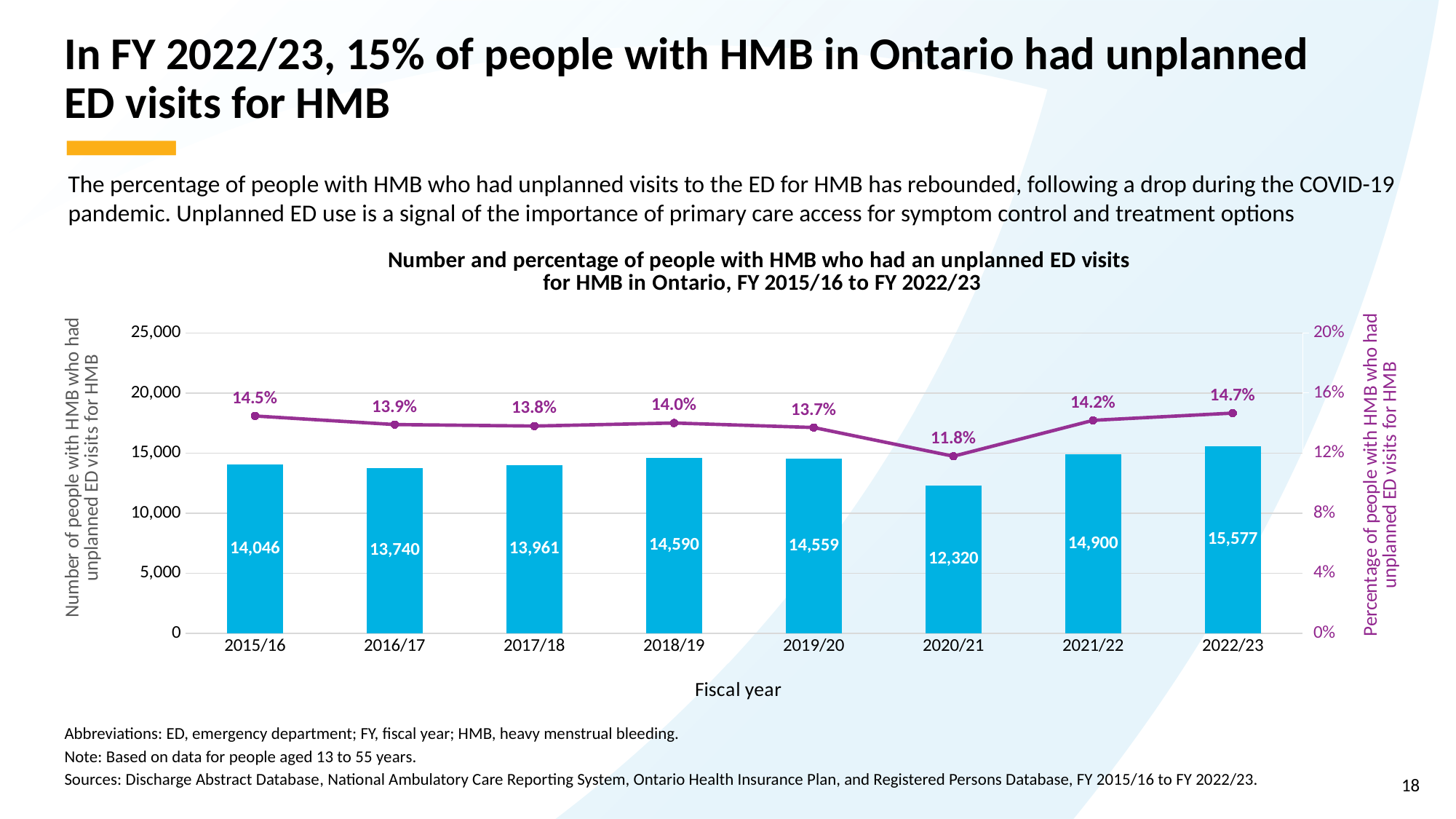
Is the number of people with unplanned ED visits in FY 2020/21 greater or less than 15,000? less Which fiscal year has the highest percentage of people with HMB who had unplanned ED visits? 2022/23 Which fiscal year has the lowest number of people with HMB who had unplanned ED visits? 2020/21 What kind of chart is used to show the number of people with HMB who had unplanned ED visits? bar chart How many fiscal years are shown on the x axis of the chart? 8 What is the number of people with HMB who had unplanned ED visits for HMB in FY 2022/23? 15,577 Did the percentage of people with HMB who had unplanned ED visits rise or fall from FY 2020/21 to FY 2022/23? rise What is the label of the x axis of the chart? Fiscal year What is the difference in the number of people with unplanned ED visits between FY 2022/23 and FY 2020/21? 3,257 What is the number of people with HMB who had unplanned ED visits in FY 2016/17? 13,740 Which fiscal year has the larger number of people with unplanned ED visits, 2018/19 or 2021/22? 2021/22 What percentage of people with HMB had unplanned ED visits for HMB in FY 2020/21? 11.8%